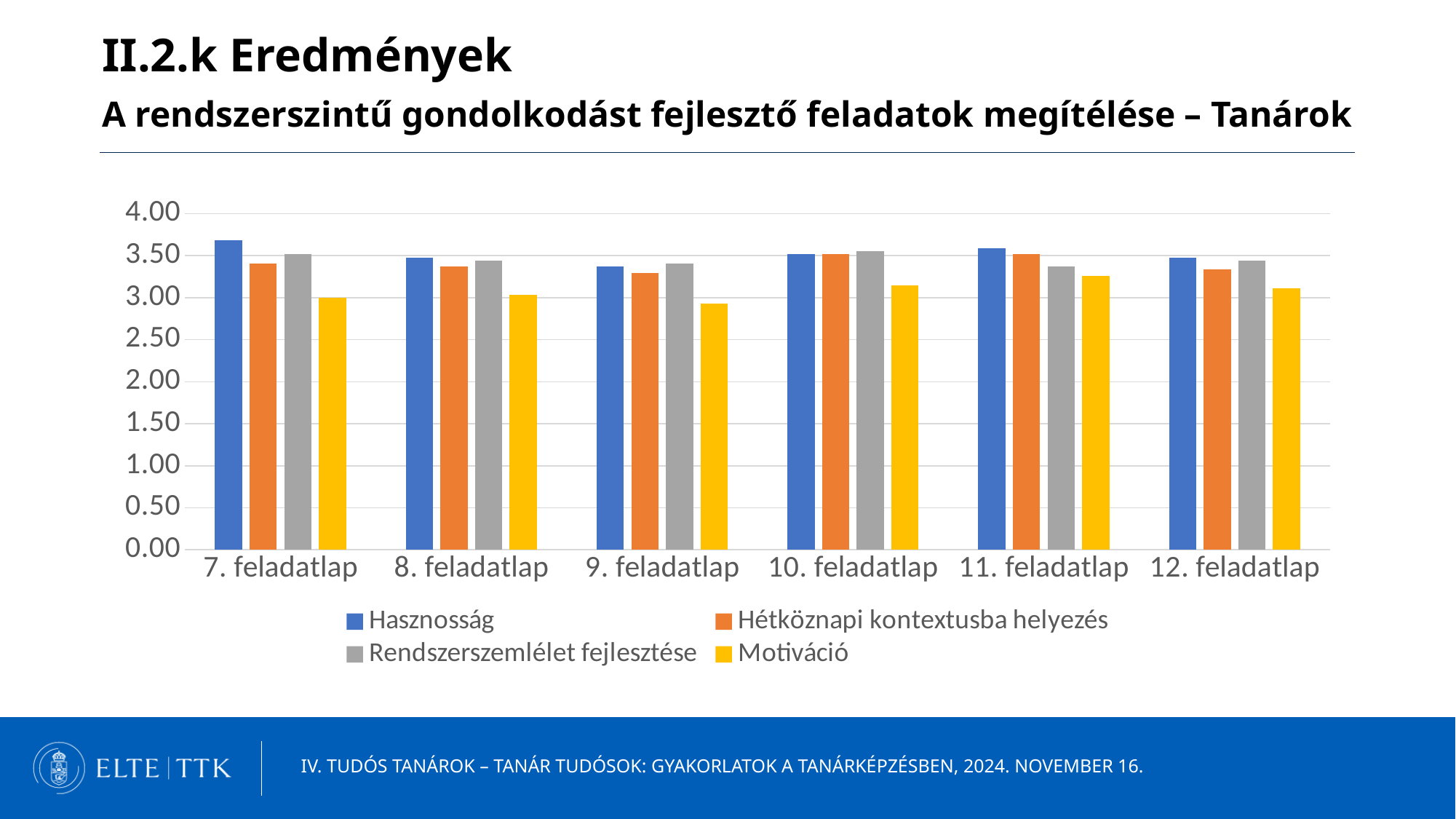
Which series has the lowest value in every feladatlap group? Motiváció For 11. feladatlap, which is larger: Hasznosság or Rendszerszemlélet fejlesztése? Hasznosság How many series does the legend list? 4 Is the Motiváció value for 7. feladatlap greater or less than 3.50? less For 9. feladatlap, which is larger: Rendszerszemlélet fejlesztése or Motiváció? Rendszerszemlélet fejlesztése How many feladatlap categories are shown on the x axis? 6 For which feladatlap is the Hasznosság value highest? 7. feladatlap Is the Hétköznapi kontextusba helyezés value for 9. feladatlap greater or less than 3.50? less Is the Motiváció value for 11. feladatlap greater or less than 3.00? greater What kind of chart is shown on the slide? bar chart Which colour represents the Motiváció series in the legend? yellow